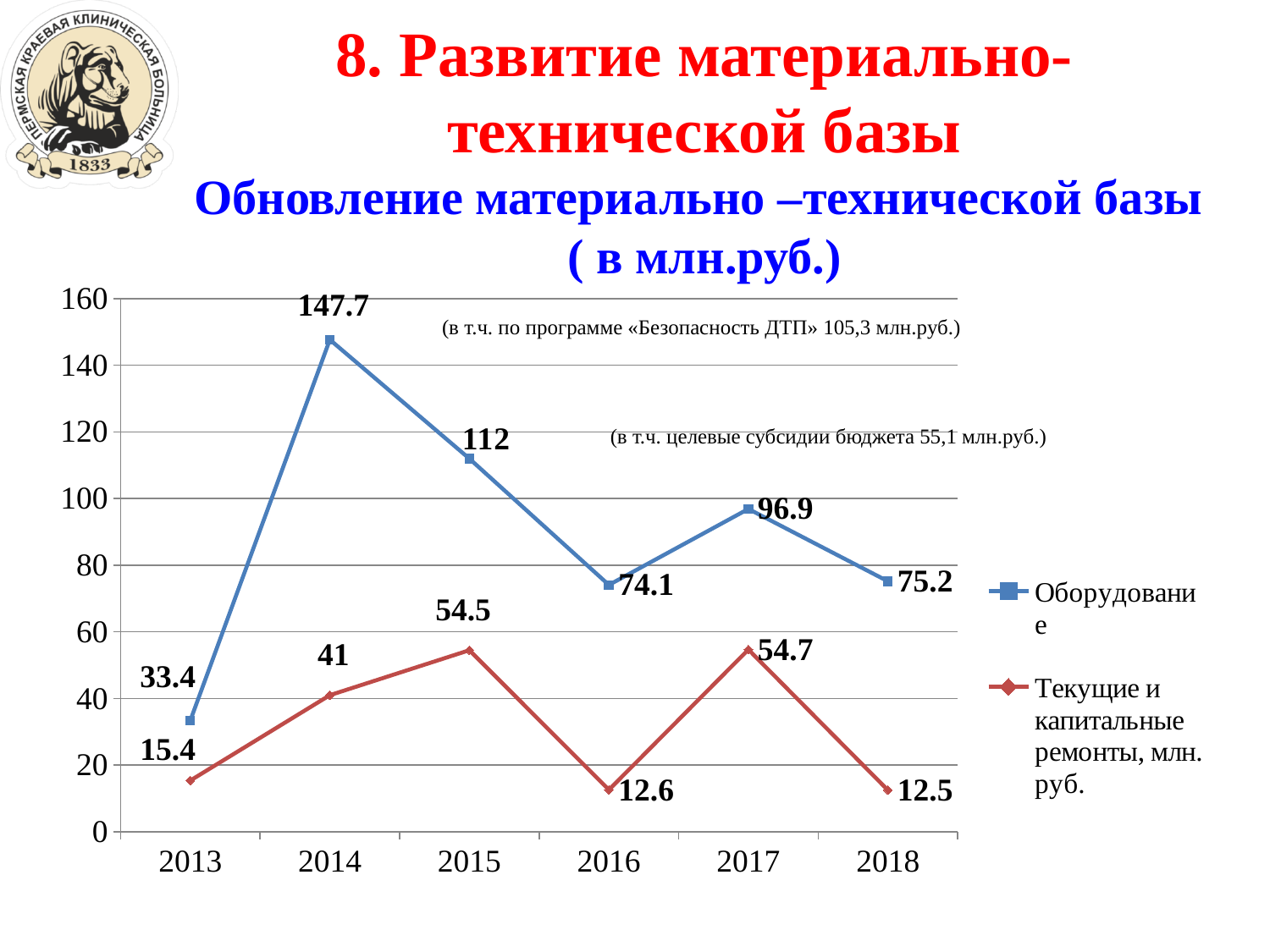
What kind of chart is shown on the slide? line chart What is the value for Оборудование in 2018? 75.2 In which year is the Текущие и капитальные ремонты value lowest? 2018 Does the Оборудование value rise or fall from 2015 to 2016? fall What is the difference between the Оборудование values in 2014 and 2015? 35.7 Is the Оборудование value in 2015 greater or less than 100? greater Which is larger: the Оборудование value in 2016 or in 2017? 2017 What is the value for Оборудование in 2014? 147.7 In which year is the Оборудование value highest? 2014 What is the value for Текущие и капитальные ремонты in 2015? 54.5 How many series does the legend list? 2 How many years are shown on the x axis? 6